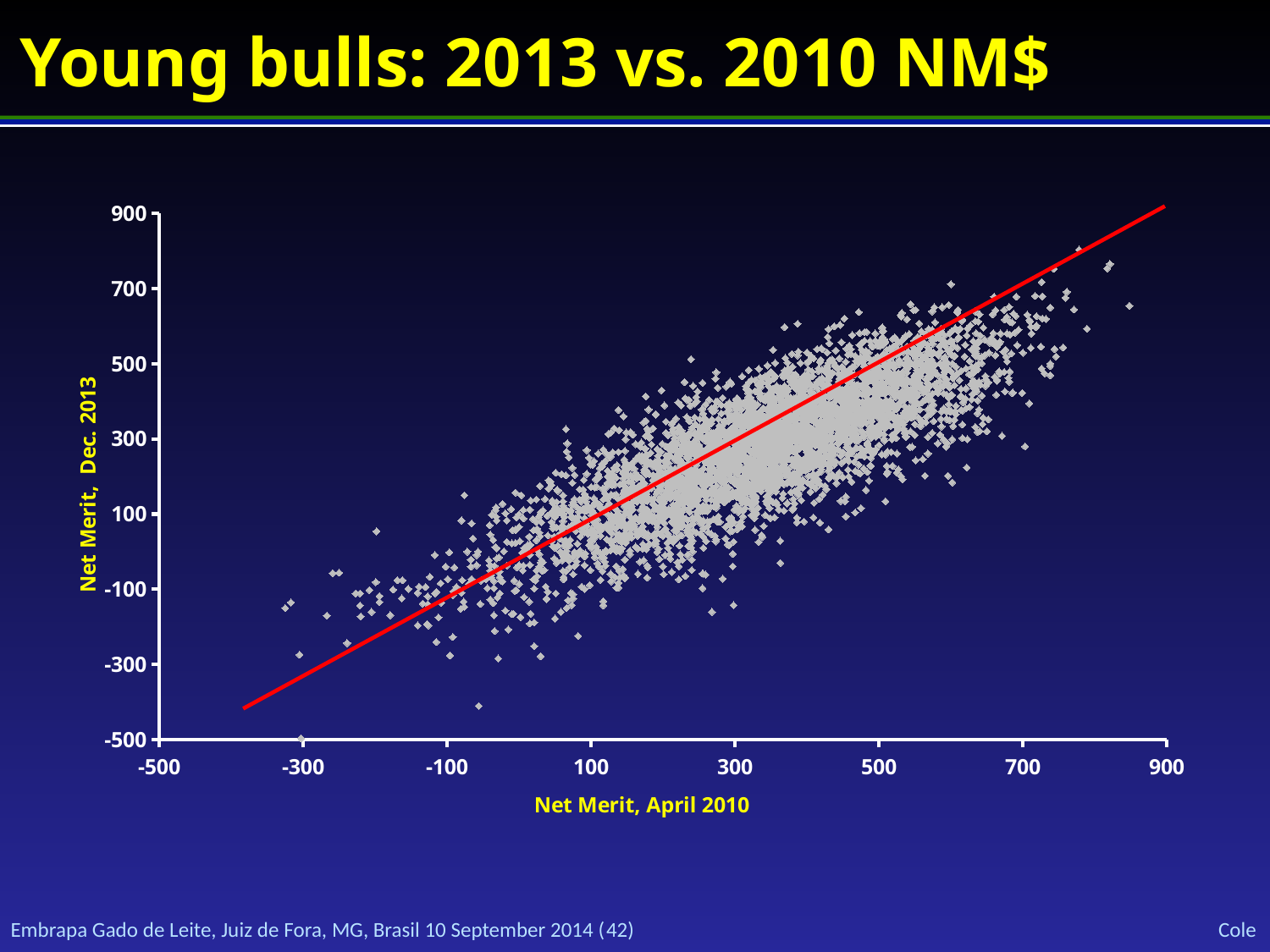
What is the title of the x axis? Net Merit, April 2010 What kind of chart is shown on the slide? scatter chart What is the lowest value shown on the x axis? -500 Is the value of the red trend line at Net Merit, April 2010 = -300 greater or less than -100? less What is the title of the y axis? Net Merit, Dec. 2013 How many tick labels are shown on the x axis? 8 Do the Net Merit, Dec. 2013 values generally rise or fall as Net Merit, April 2010 increases? rise Is the value of the red trend line at Net Merit, April 2010 = 300 greater or less than 100? greater What is the highest value shown on the y axis? 900 Is the value of the red trend line at Net Merit, April 2010 = 900 greater or less than 700? greater